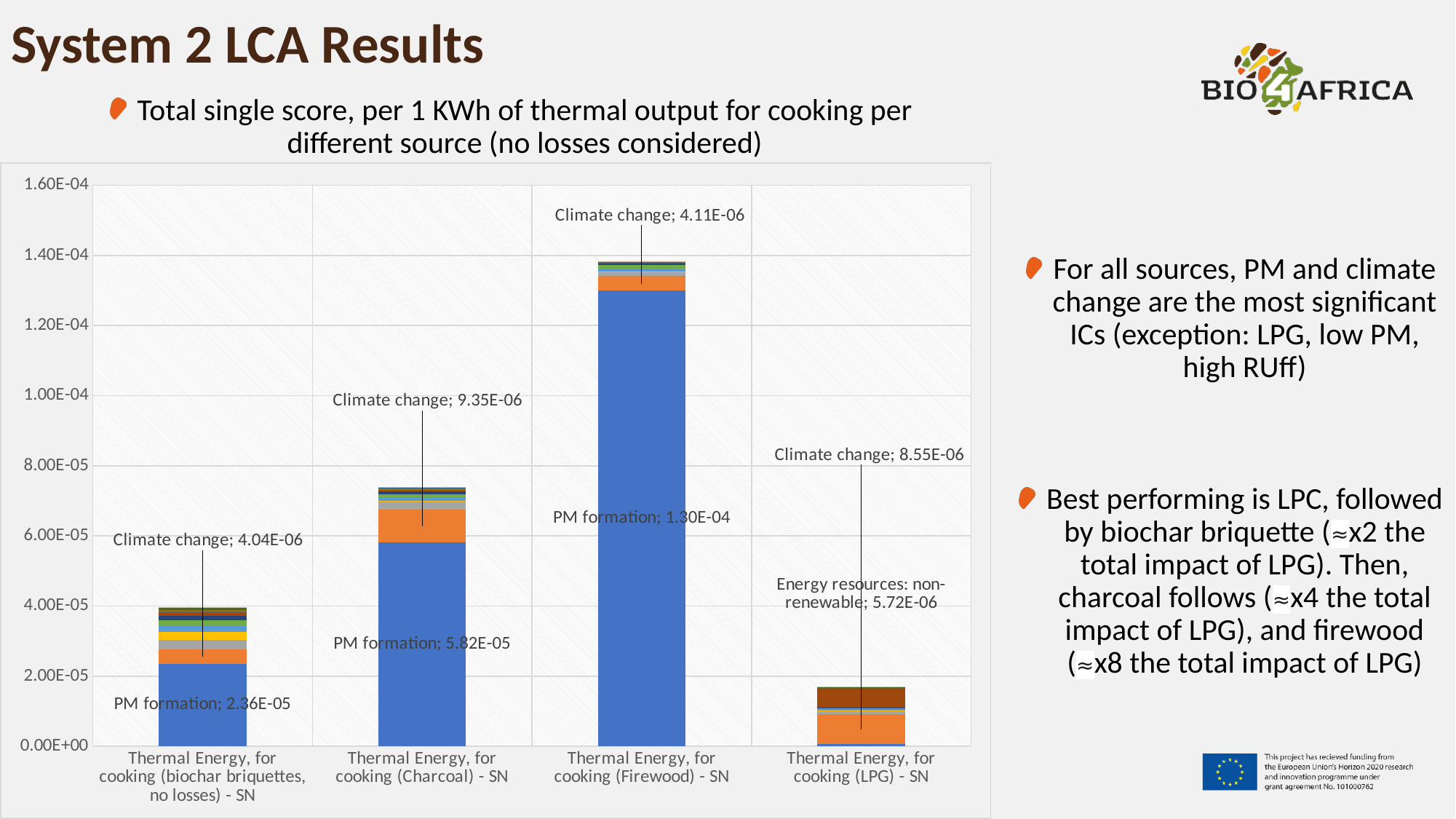
Is the total stacked bar for Thermal Energy, for cooking (Firewood) - SN greater or less than 1.20E-04? greater What is the PM formation value for Thermal Energy, for cooking (biochar briquettes, no losses) - SN? 2.36E-05 Which category has the tallest stacked bar? Thermal Energy, for cooking (Firewood) - SN What is the PM formation value for Thermal Energy, for cooking (Firewood) - SN? 1.30E-04 What is the difference between the PM formation value for Firewood and for Charcoal? 7.18E-05 What is the Climate change value for Thermal Energy, for cooking (Charcoal) - SN? 9.35E-06 What is the Energy resources: non-renewable value for Thermal Energy, for cooking (LPG) - SN? 5.72E-06 How many categories are shown on the x axis? 4 Which category has the shortest stacked bar? Thermal Energy, for cooking (LPG) - SN What kind of chart is shown on the slide? Stacked bar chart What is the Climate change value for Thermal Energy, for cooking (LPG) - SN? 8.55E-06 Which has the larger PM formation value: Charcoal or biochar briquettes? Charcoal